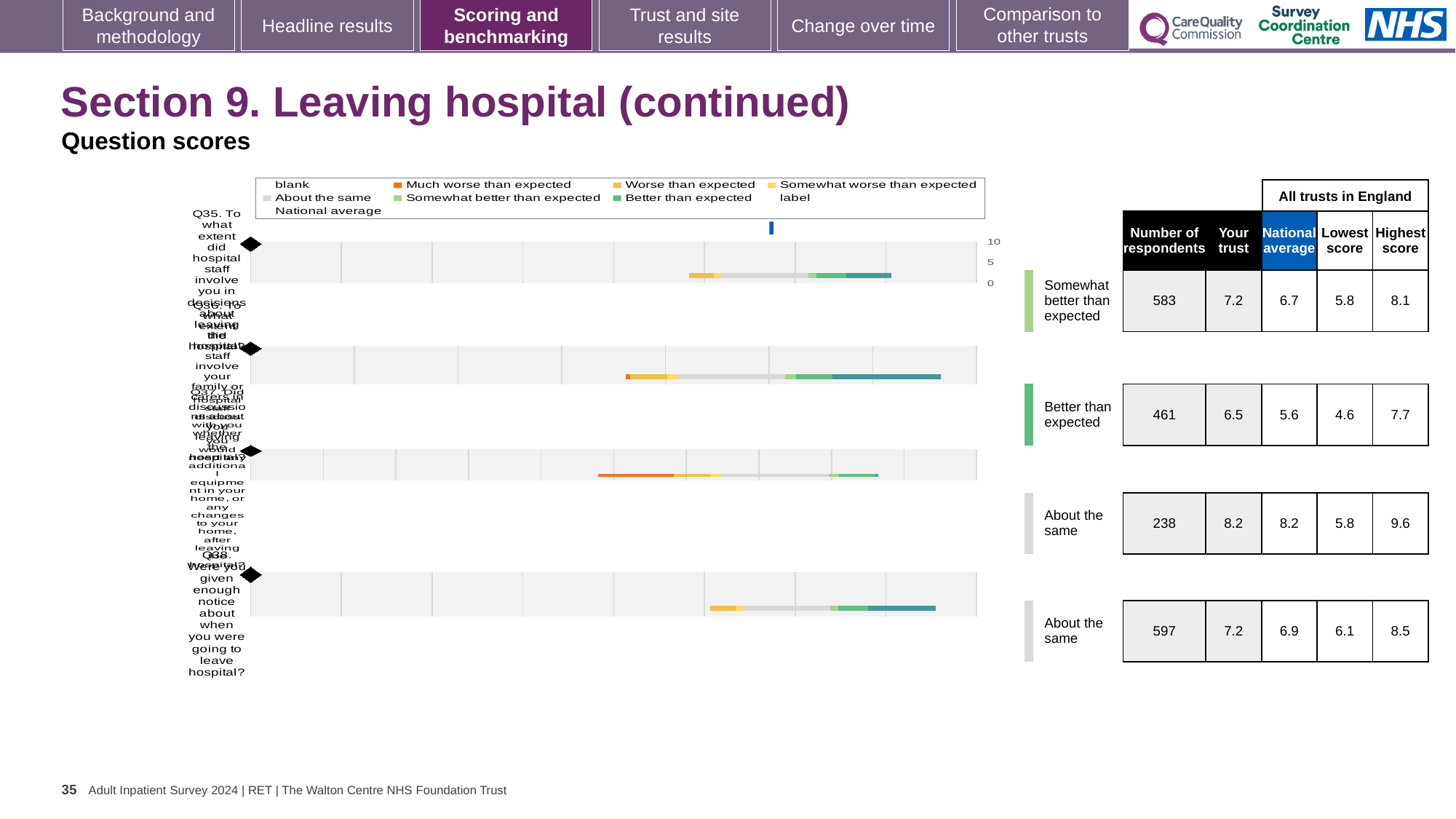
Which question has the lowest 'Your trust' score on this slide? Q36 Which question has the highest 'Your trust' score on this slide? Q37 How many questions are plotted on this slide? 4 What is the 'Your trust' score for Q35? 7.2 What benchmark category is shown for Q36? Better than expected For Q38, which is larger: the 'Your trust' score or the national average? Your trust What is the national average score for Q36 (involving your family or carers in discussions about leaving hospital)? 5.6 For Q35, what is the difference between the 'Your trust' score and the national average? 0.5 What is the highest score across all trusts in England for Q38 (enough notice about leaving hospital)? 8.5 How many respondents are shown for Q35 (involving you in decisions about leaving hospital)? 583 What kind of chart is used to show the question scores? Bar chart What is the 'Your trust' score for Q37 (discussing additional equipment or changes to your home)? 8.2